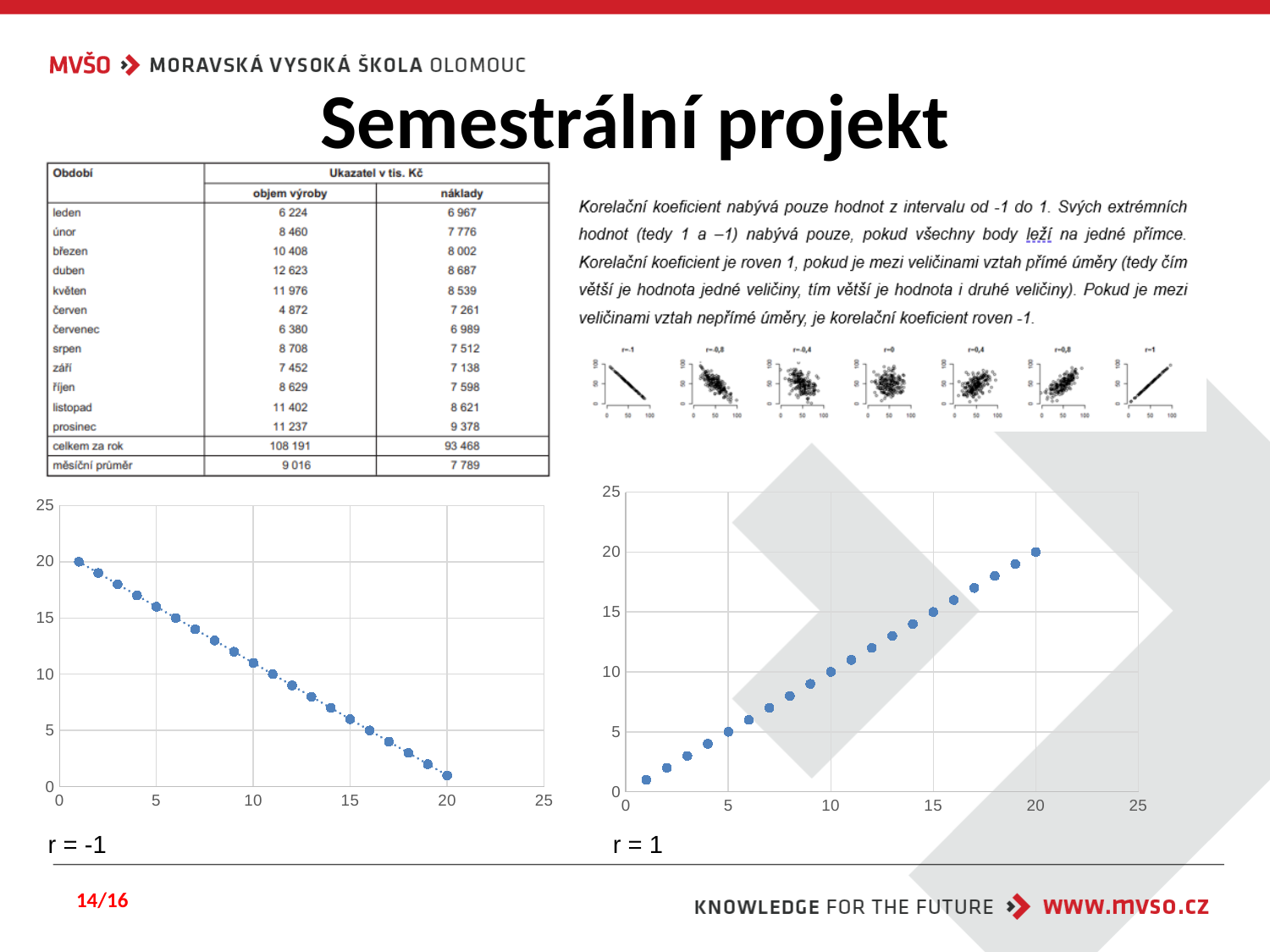
What kind of chart is the left chart labelled r = -1? scatter chart In the left chart (r = -1), is the y value of the point at x = 15 greater or less than 10? less In the left chart (r = -1), which point has the highest y value, the one at x = 1 or the one at x = 20? x = 1 How many points are plotted in the right chart (r = 1)? 20 In the right chart (r = 1), what is the y value of the point at x = 20? 20 How many points are plotted in the left chart (r = -1)? 20 In the right chart (r = 1), what is the y value of the point at x = 10? 10 In the left chart (r = -1), is the y value of the point at x = 5 greater or less than 15? greater What kind of chart is the right chart labelled r = 1? scatter chart In the right chart (r = 1), do the values rise or fall as x increases? rise What is the maximum value shown on the y axis of the right chart (r = 1)? 25 In the left chart (r = -1), do the values rise or fall as x increases? fall